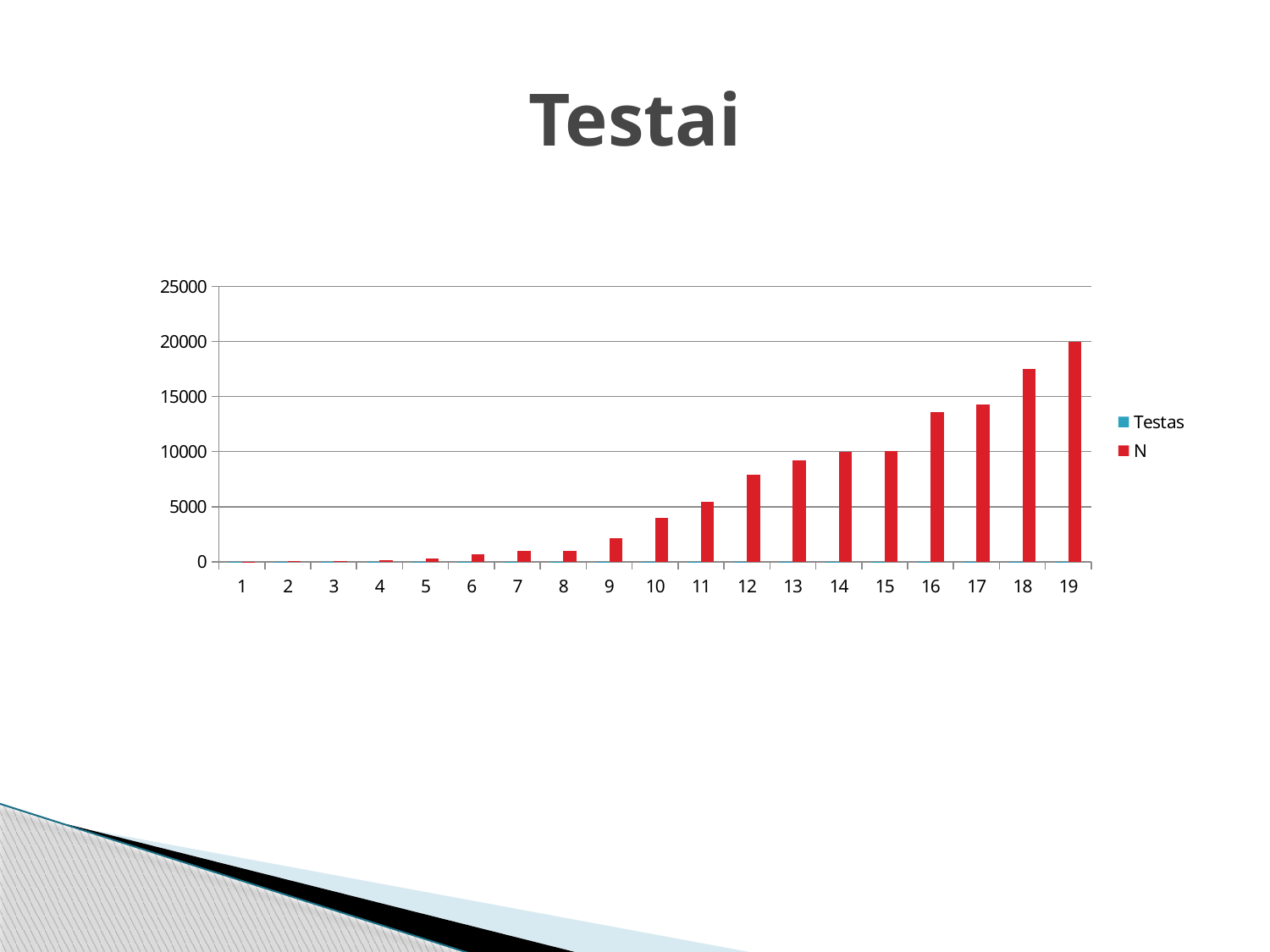
Is the value of N for category 19 greater or less than 15000? greater Is the value of N for category 16 greater or less than 10000? greater What colour are the bars for the N series? red Do the N values generally rise or fall from category 1 to category 19? rise Which is larger, the N value for category 17 or for category 13? 17 What kind of chart is shown on the slide? bar chart How many categories are shown on the x axis? 19 Which category has the highest value for the N series? 19 What is the title of the slide containing the chart? Testai Is the value of N for category 12 greater or less than 10000? less How many series does the legend list? 2